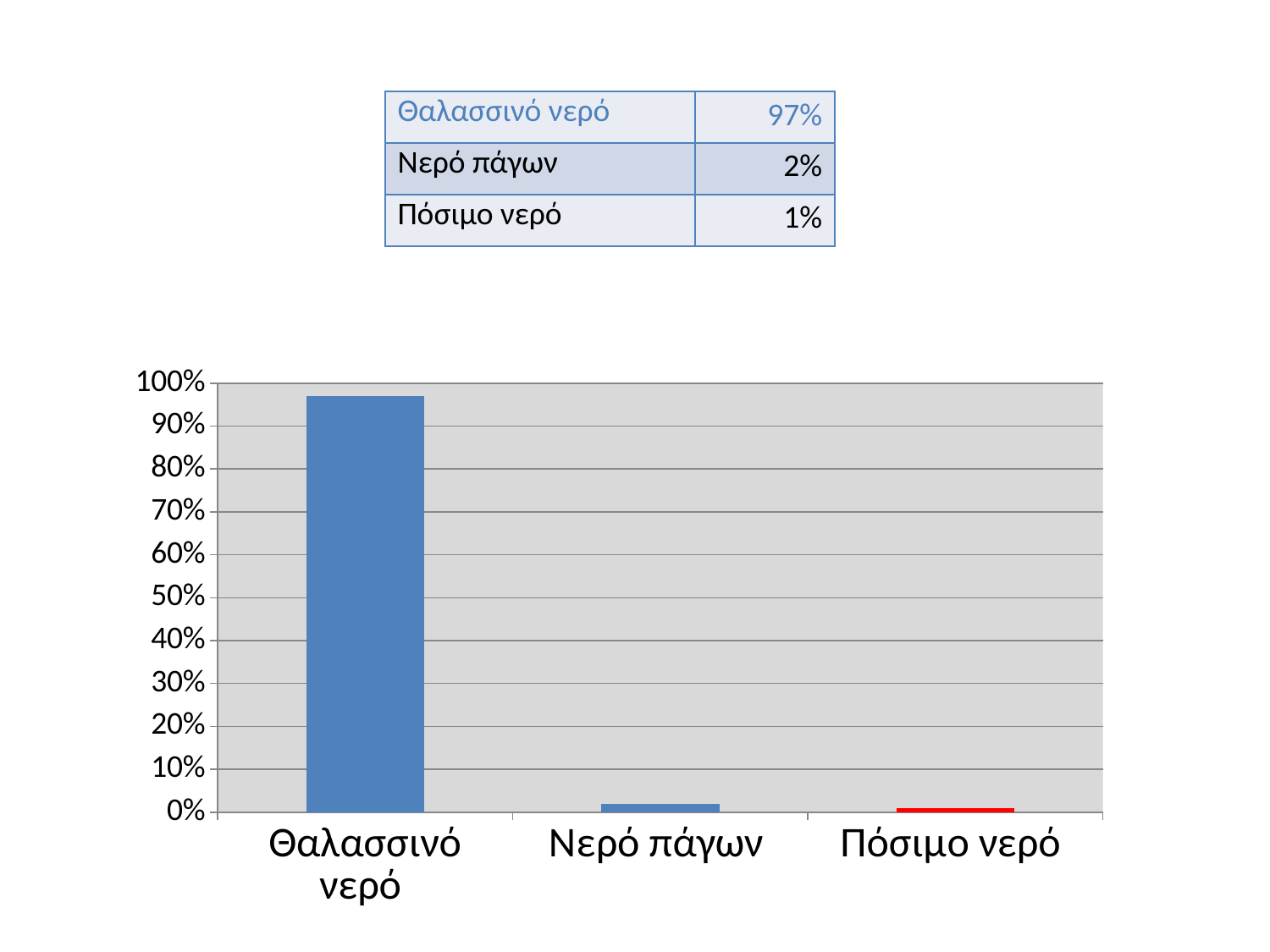
What colour is the bar for Πόσιμο νερό? red Using the values in the table, what is the difference between Θαλασσινό νερό and Πόσιμο νερό? 96% Is the value for Νερό πάγων greater or less than 10%? less Which category has the lowest bar in the chart? Πόσιμο νερό Which category has the highest bar in the chart? Θαλασσινό νερό Is the value for Θαλασσινό νερό greater or less than 90%? greater According to the table on the slide, what is the value for Νερό πάγων? 2% What type of chart is shown on the slide? bar chart Which is larger, the value for Θαλασσινό νερό or the value for Νερό πάγων? Θαλασσινό νερό According to the table on the slide, what is the value for Πόσιμο νερό? 1% How many categories are shown on the x axis of the chart? 3 According to the table on the slide, what is the value for Θαλασσινό νερό? 97%